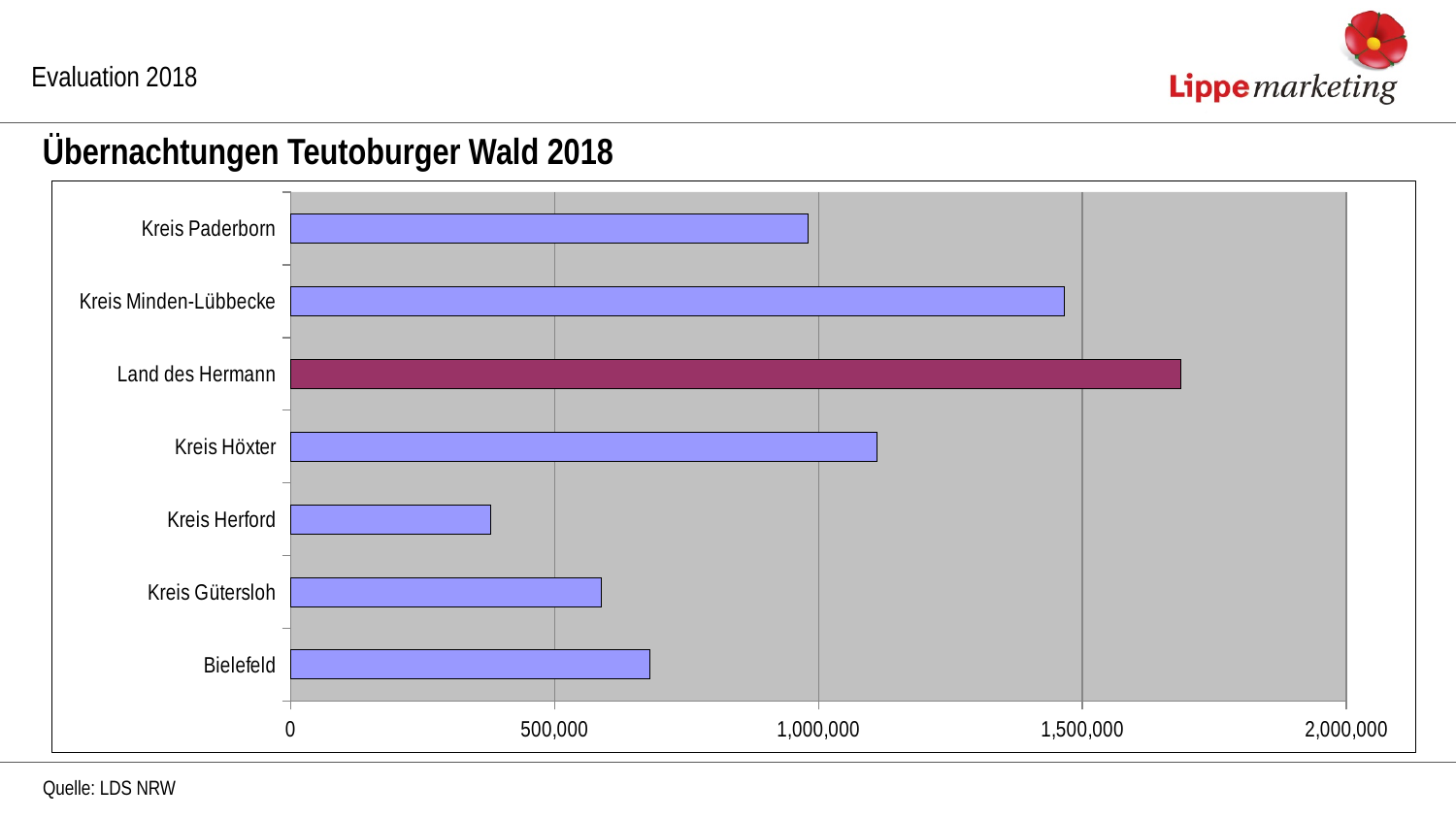
What kind of chart is shown on the slide? bar chart How many categories are plotted in the chart? 7 Is the value for Kreis Höxter greater or less than 1,000,000? greater Is the value for Land des Hermann greater or less than 1,500,000? greater Which has more overnight stays, Kreis Minden-Lübbecke or Kreis Höxter? Kreis Minden-Lübbecke Which has more overnight stays, Bielefeld or Kreis Gütersloh? Bielefeld Which category has the highest number of overnight stays? Land des Hermann Is the value for Kreis Paderborn greater or less than 1,000,000? less What is the title of the chart? Übernachtungen Teutoburger Wald 2018 Which category has the lowest number of overnight stays? Kreis Herford